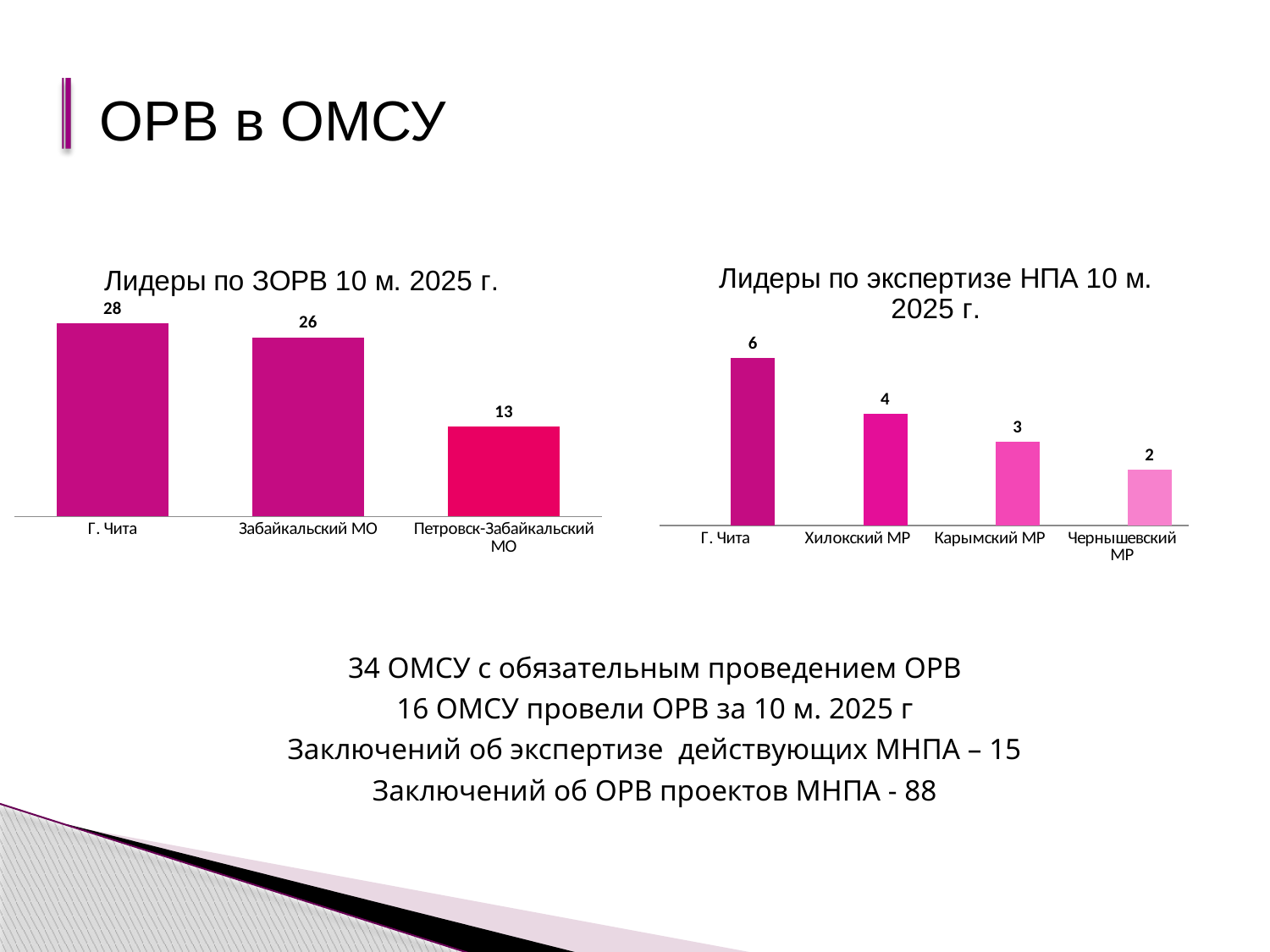
In the chart 'Лидеры по экспертизе НПА 10 м. 2025 г.', how many categories are shown? 4 In the chart 'Лидеры по экспертизе НПА 10 м. 2025 г.', what is the difference between Г. Чита and Чернышевский МР? 4 What kind of chart is the left chart on the slide? bar chart In the chart 'Лидеры по ЗОРВ 10 м. 2025 г.', what is the value for Петровск-Забайкальский МО? 13 In the chart 'Лидеры по ЗОРВ 10 м. 2025 г.', what is the difference between Г. Чита and Забайкальский МО? 2 In the chart 'Лидеры по ЗОРВ 10 м. 2025 г.', which category has the lowest value? Петровск-Забайкальский МО In the chart 'Лидеры по ЗОРВ 10 м. 2025 г.', what is the value for Г. Чита? 28 In the chart 'Лидеры по экспертизе НПА 10 м. 2025 г.', which category has the highest value? Г. Чита In the chart 'Лидеры по экспертизе НПА 10 м. 2025 г.', what is the value for Хилокский МР? 4 In the chart 'Лидеры по экспертизе НПА 10 м. 2025 г.', which is larger: Карымский МР or Чернышевский МР? Карымский МР In the chart 'Лидеры по экспертизе НПА 10 м. 2025 г.', do the values rise or fall from left to right? fall In the chart 'Лидеры по ЗОРВ 10 м. 2025 г.', how many categories are shown? 3